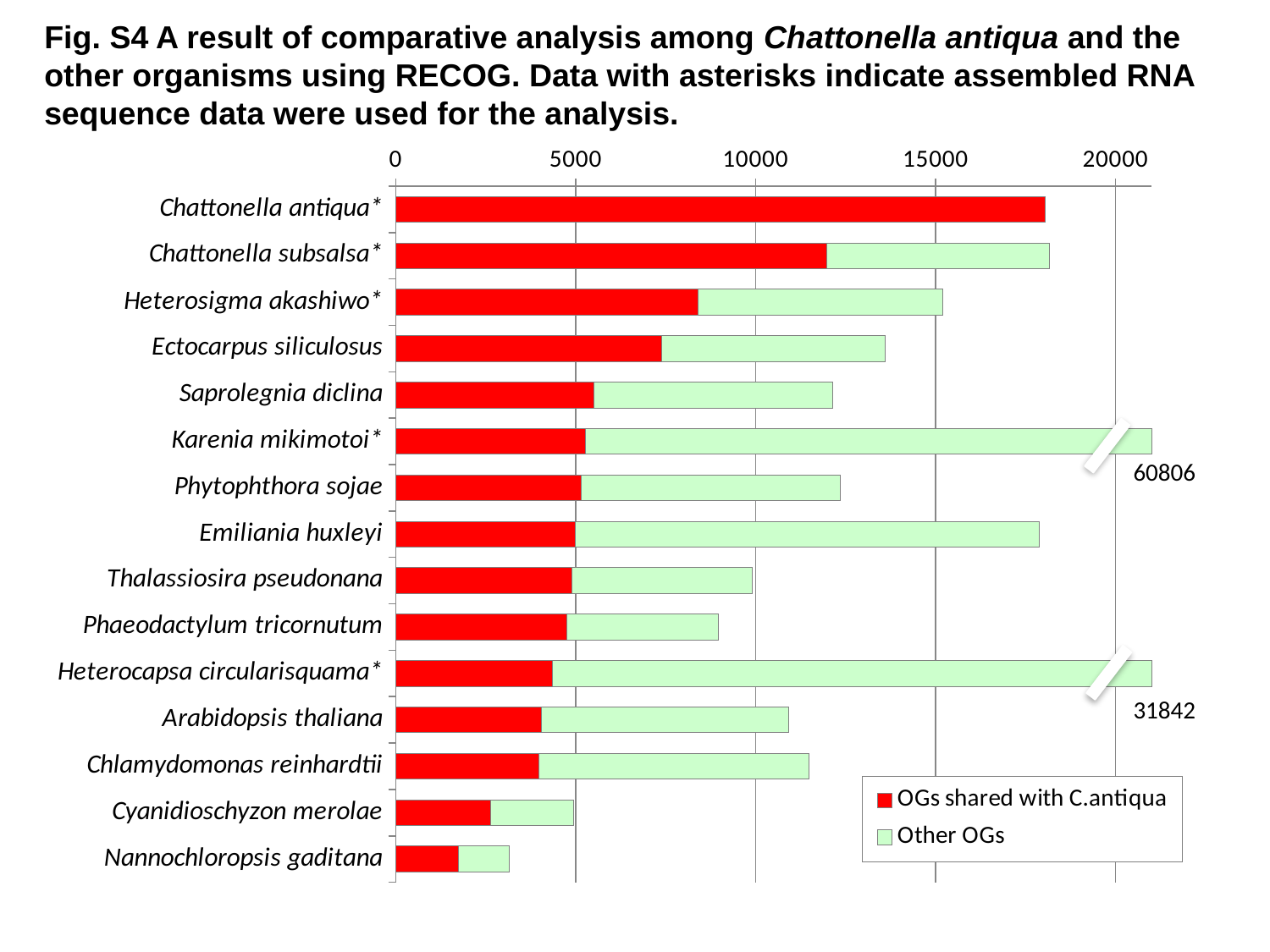
Which has the larger value of OGs shared with C.antiqua: Chattonella subsalsa* or Heterosigma akashiwo*? Chattonella subsalsa* What total value is annotated next to the bar for Karenia mikimotoi*? 60806 What are the two series named in the legend? OGs shared with C.antiqua; Other OGs What type of chart is shown on the slide? Stacked bar chart What total value is annotated next to the bar for Heterocapsa circularisquama*? 31842 Is the value of OGs shared with C.antiqua for Chattonella antiqua* greater or less than 15000? greater Which organism has the lowest value for OGs shared with C.antiqua? Nannochloropsis gaditana How many organisms (categories) are plotted on the chart? 15 Which organism has the highest value for OGs shared with C.antiqua? Chattonella antiqua* How many series does the legend list? 2 Going down the list of organisms from top to bottom, do the values of OGs shared with C.antiqua rise or fall? fall Is the value of OGs shared with C.antiqua for Heterosigma akashiwo* greater or less than 10000? less